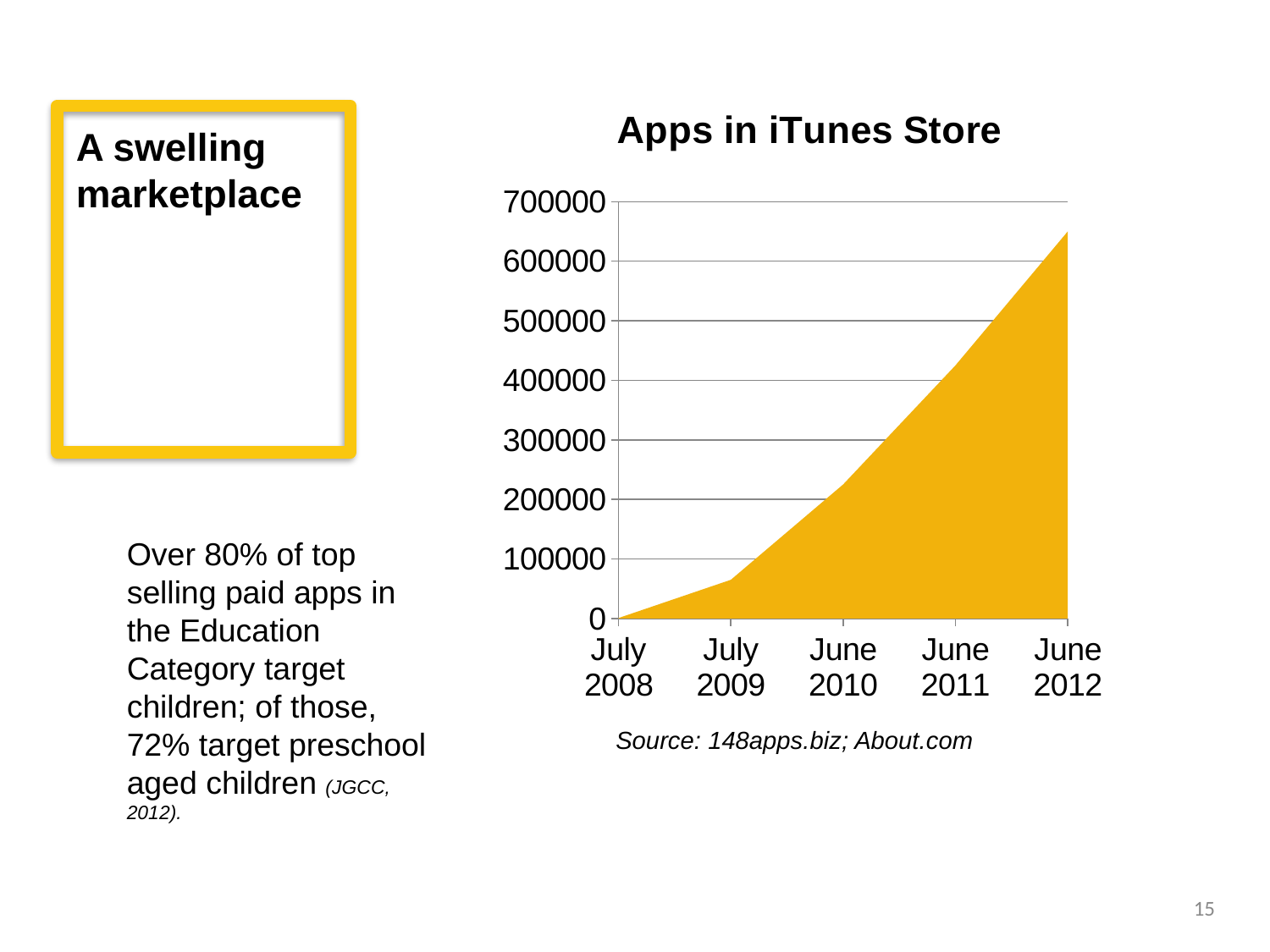
Is the value for July 2009 greater or less than 100000? less What kind of chart is shown on the slide? area chart Which time point has the highest value in the chart? June 2012 How many time points are plotted along the x axis of the chart? 5 Is the value for June 2012 greater or less than 600000? greater Do the values in the chart rise or fall from July 2008 to June 2012? rise Is the value for June 2010 greater or less than 300000? less What source is cited below the chart? 148apps.biz; About.com Which time point has the lowest value in the chart? July 2008 What is the title of the chart? Apps in iTunes Store Which is larger, the value for June 2012 or the value for July 2009? June 2012